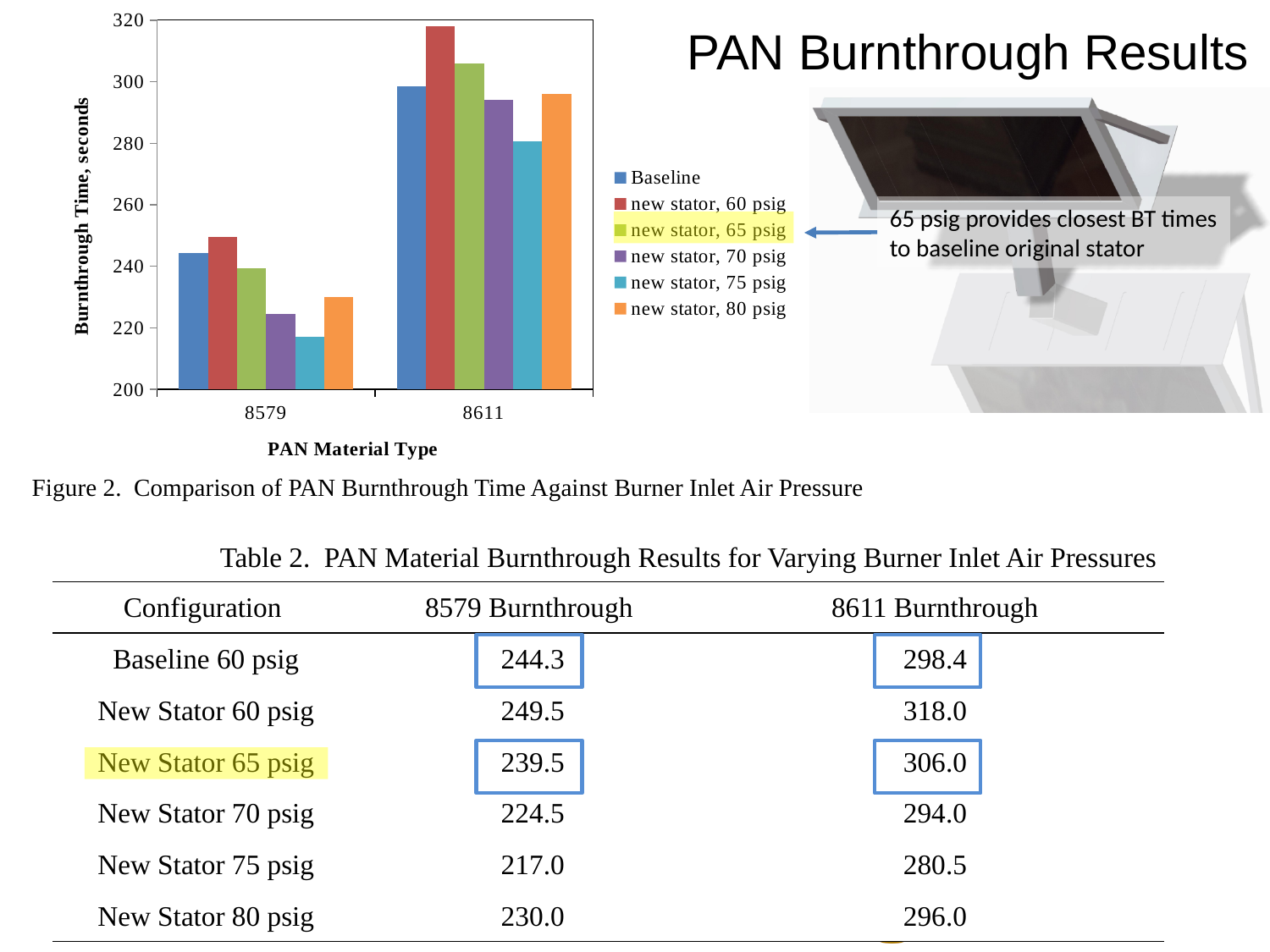
How many PAN material types are shown on the x axis of the chart? 2 How many series does the legend of the chart list? 6 Is the burnthrough time for new stator, 60 psig on material 8611 greater or less than 300? greater What is the label of the y axis of the chart? Burnthrough Time, seconds What is the Baseline burnthrough time for material 8579? 244.3 Is the Baseline burnthrough time for material 8579 greater or less than 260? less For PAN material 8611, which series has the highest burnthrough time? new stator, 60 psig For the Baseline series, which material has the larger burnthrough time, 8579 or 8611? 8611 What is the difference between the new stator, 60 psig and Baseline burnthrough times for material 8611? 19.6 For material 8611, which is larger: the burnthrough time for new stator, 65 psig or new stator, 70 psig? new stator, 65 psig For PAN material 8579, which series has the lowest burnthrough time? new stator, 75 psig What kind of chart is shown in Figure 2? bar chart